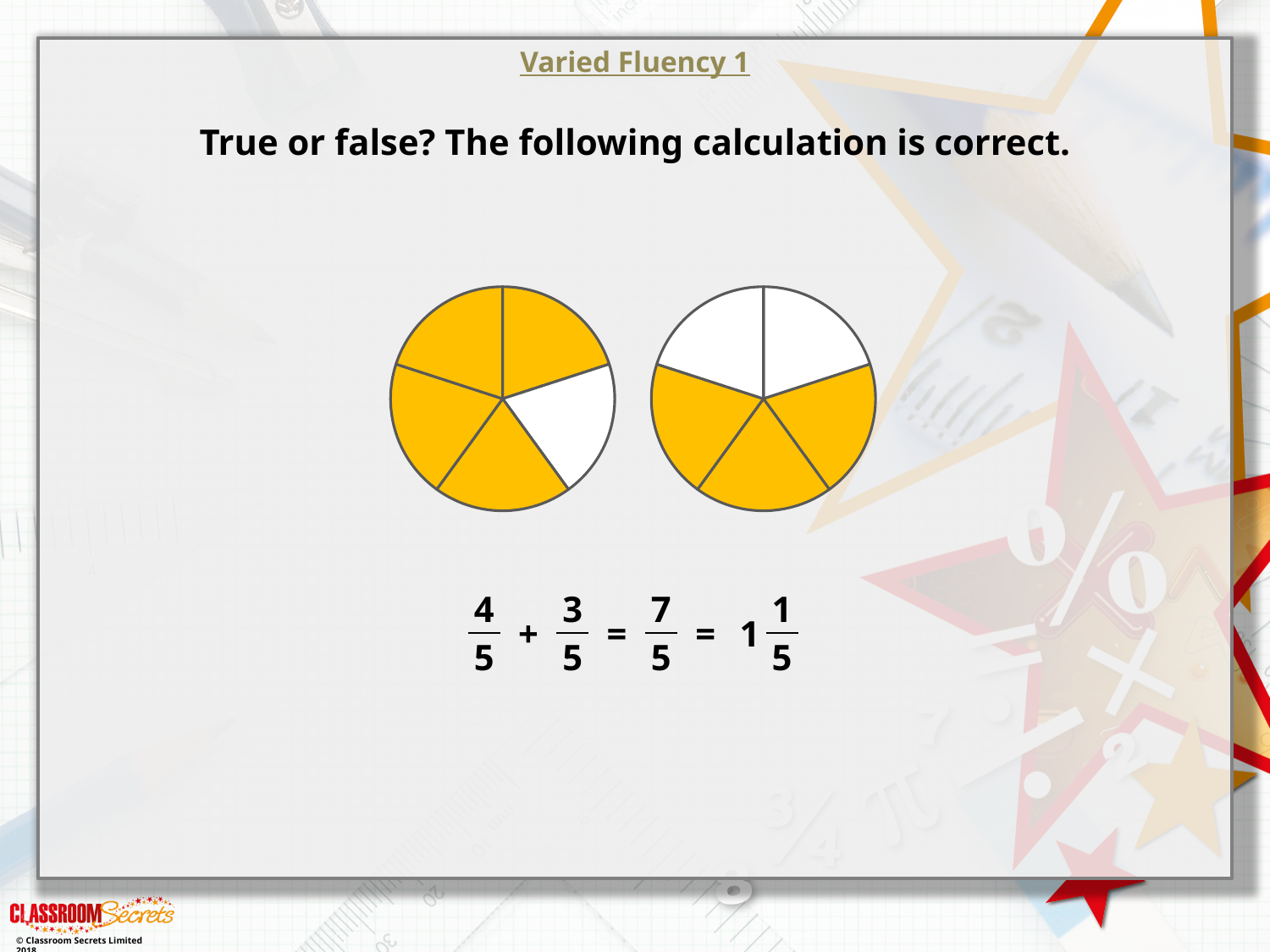
In the right circle, how many sections are left white? 2 What fraction of the left circle is shaded yellow? 4/5 How many equal sections is the right circle divided into? 5 In the left circle, how many sections are left white? 1 What fraction of the right circle is shaded yellow? 3/5 Which circle has more shaded sections, the left or the right? left What kind of chart are the two circular diagrams on the slide? pie chart What colour are the shaded sections in both circles? yellow How many more shaded sections does the left circle have than the right circle? 1